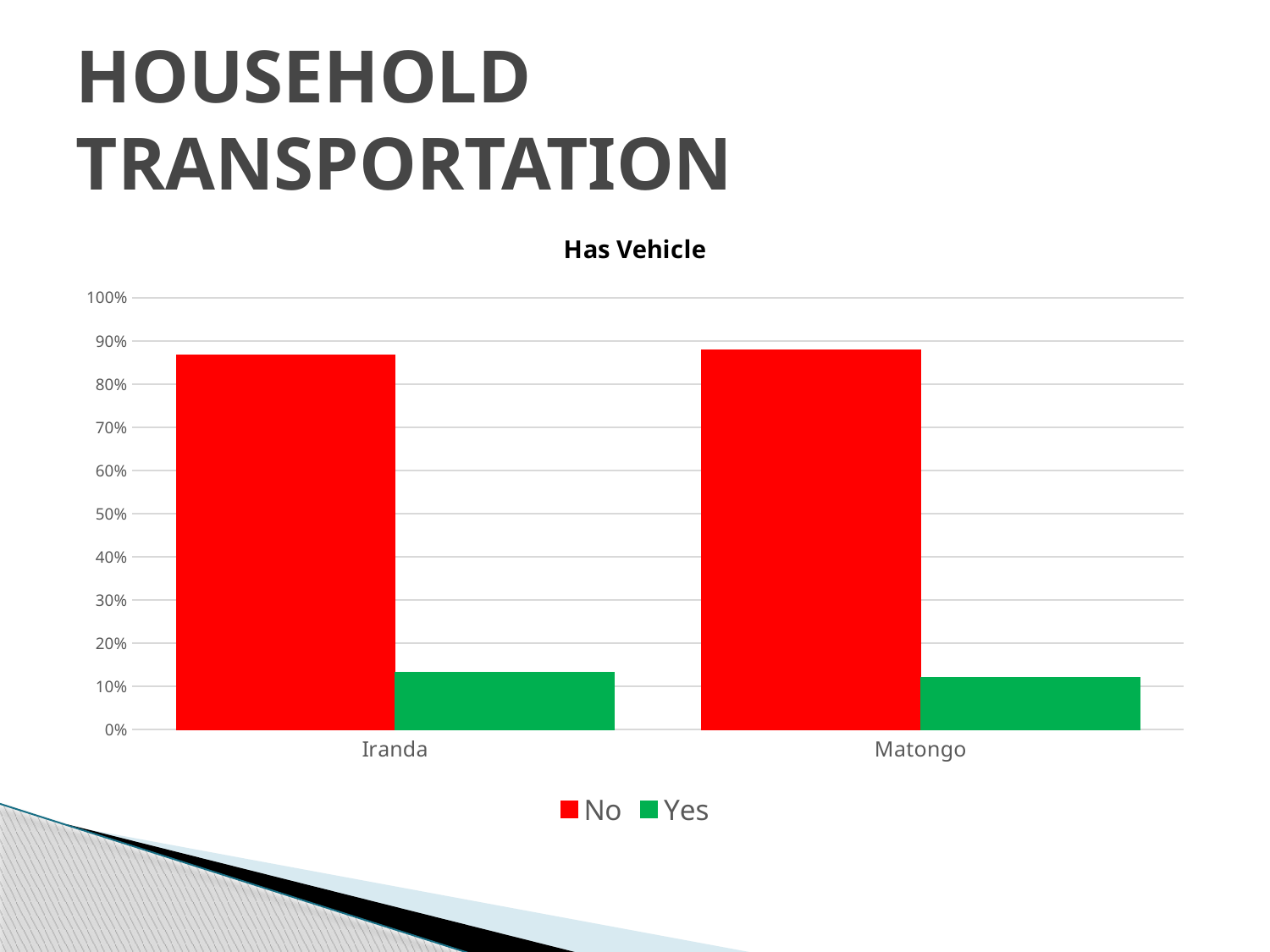
Is the value for Yes in Matongo greater or less than 20%? less What is the title of the chart? Has Vehicle Is the value for No in Matongo greater or less than 80%? greater For Iranda, which is larger: No or Yes? No Is the value for No in Matongo greater or less than 50%? greater How many series does the legend list? 2 What are the two entries in the chart's legend? No, Yes How many categories are shown on the x axis of the chart? 2 For Matongo, which is larger: No or Yes? No What kind of chart is shown on the slide? bar chart